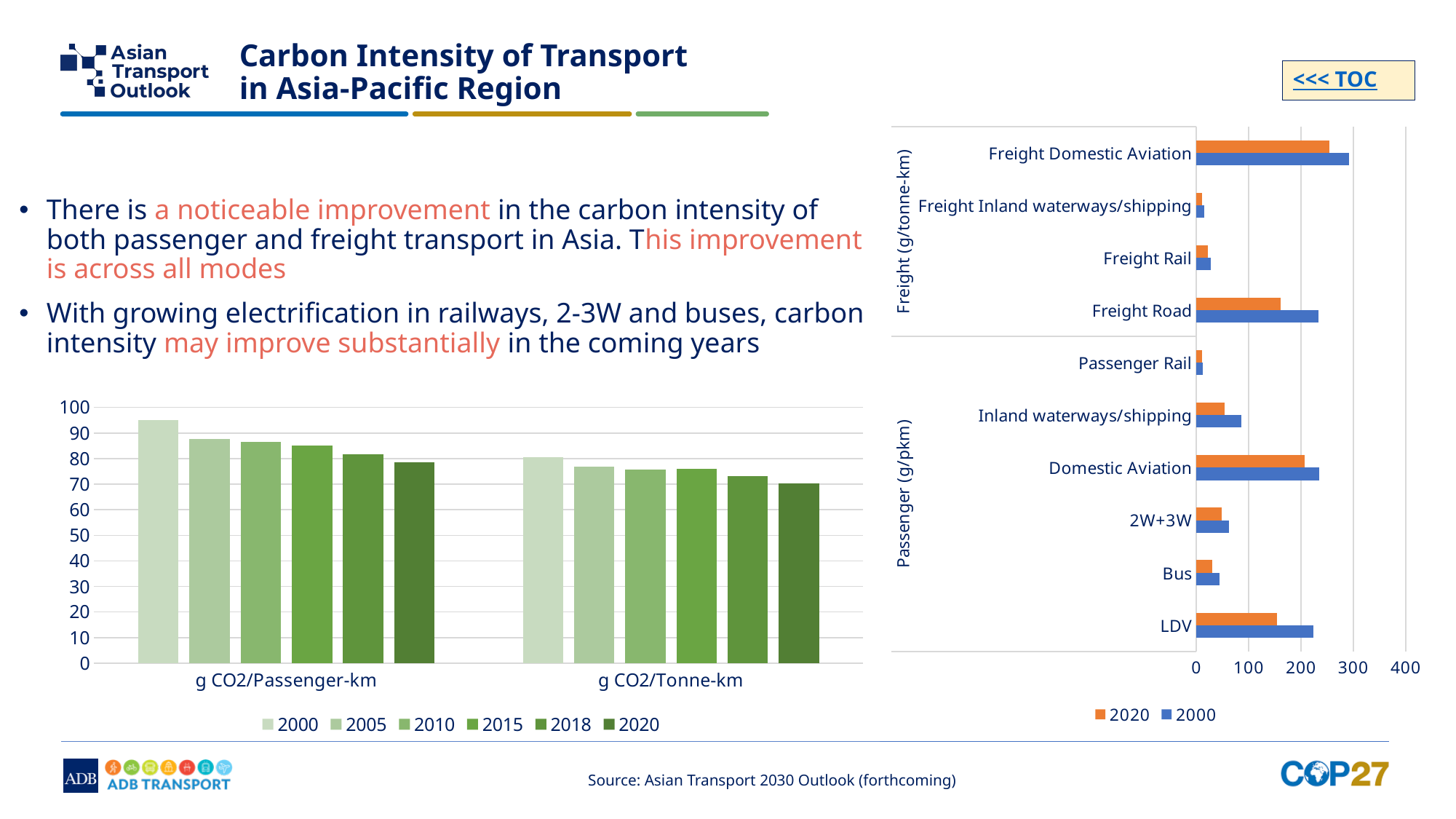
On the left chart, what kind of chart is shown? bar chart On the left chart, which category has the higher 2000 value, g CO2/Passenger-km or g CO2/Tonne-km? g CO2/Passenger-km On the left chart, is the 2020 value for g CO2/Tonne-km greater or less than 80? less On the right chart, is the 2020 value for LDV greater or less than 200? less On the right chart, how many transport modes are listed on the vertical axis? 10 On the left chart, do the g CO2/Passenger-km values rise or fall from 2000 to 2020? fall On the right chart, which mode has the highest 2000 value? Freight Domestic Aviation On the right chart, which has the larger 2000 value, LDV or Bus? LDV On the left chart, how many series does the legend list? 6 On the left chart, is the 2000 value for g CO2/Passenger-km greater or less than 90? greater On the right chart, how many series does the legend list? 2 On the left chart, how many categories are shown on the x axis? 2